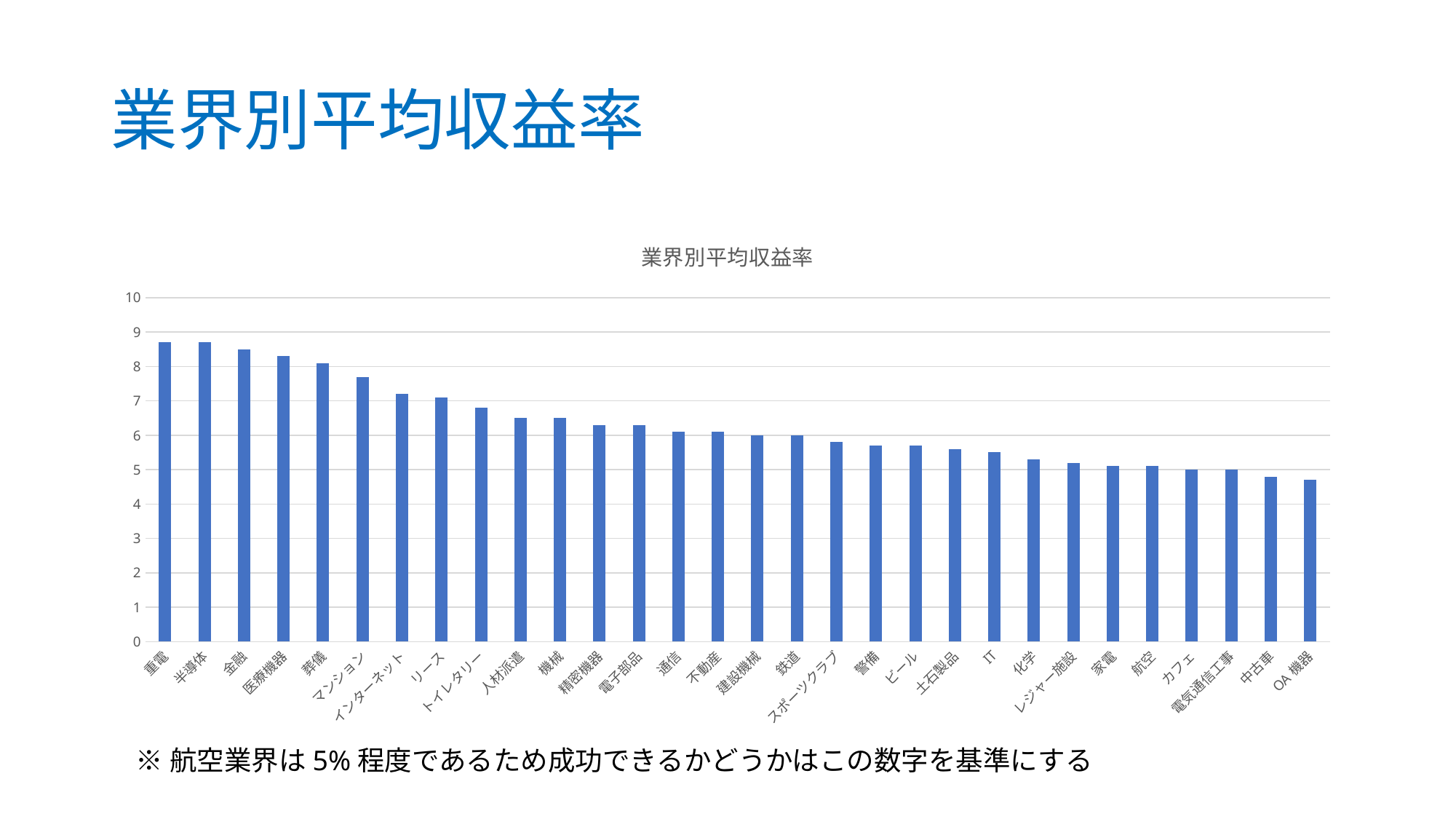
What kind of chart is shown on the slide? bar chart Is the value for 金融 greater or less than 8? greater Which has the larger value, 重電 or OA機器? 重電 Is the value for 人材派遣 greater or less than 6? greater What is the title of the chart? 業界別平均収益率 Is the value for 重電 greater or less than 8? greater Which has the larger value, 医療機器 or マンション? 医療機器 Do the values rise or fall moving from left to right along the x axis? fall How many industries (categories) are plotted in the chart? 30